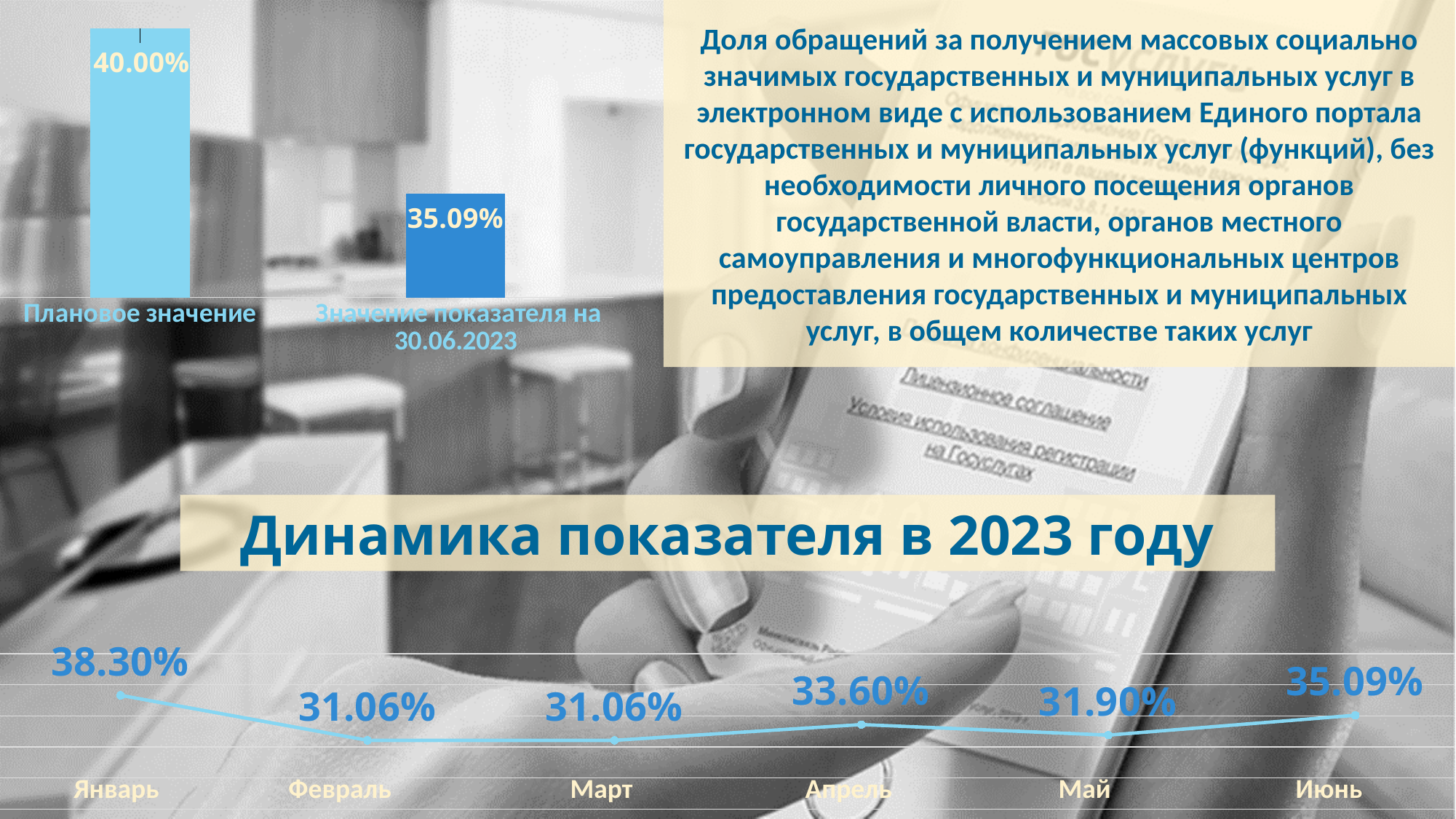
What kind of chart is shown at the top left of the slide? Bar chart In the bar chart at the top left of the slide, which bar is higher: Плановое значение or Значение показателя на 30.06.2023? Плановое значение In the bar chart at the top left of the slide, what is the value for Плановое значение? 40.00% In the chart titled 'Динамика показателя в 2023 году', which month has the highest value? Январь In the chart titled 'Динамика показателя в 2023 году', what is the value for Апрель? 33.60% In the bar chart at the top left of the slide, what is the difference between Плановое значение and Значение показателя на 30.06.2023? 4.91% What kind of chart is the one titled 'Динамика показателя в 2023 году'? Line chart In the chart titled 'Динамика показателя в 2023 году', what is the value for Май? 31.90% In the bar chart at the top left of the slide, what is the value for Значение показателя на 30.06.2023? 35.09% In the chart titled 'Динамика показателя в 2023 году', what is the difference between the values for Январь and Июнь? 3.21% In the chart titled 'Динамика показателя в 2023 году', how many months are plotted? 6 In the chart titled 'Динамика показателя в 2023 году', what is the value for Январь? 38.30%